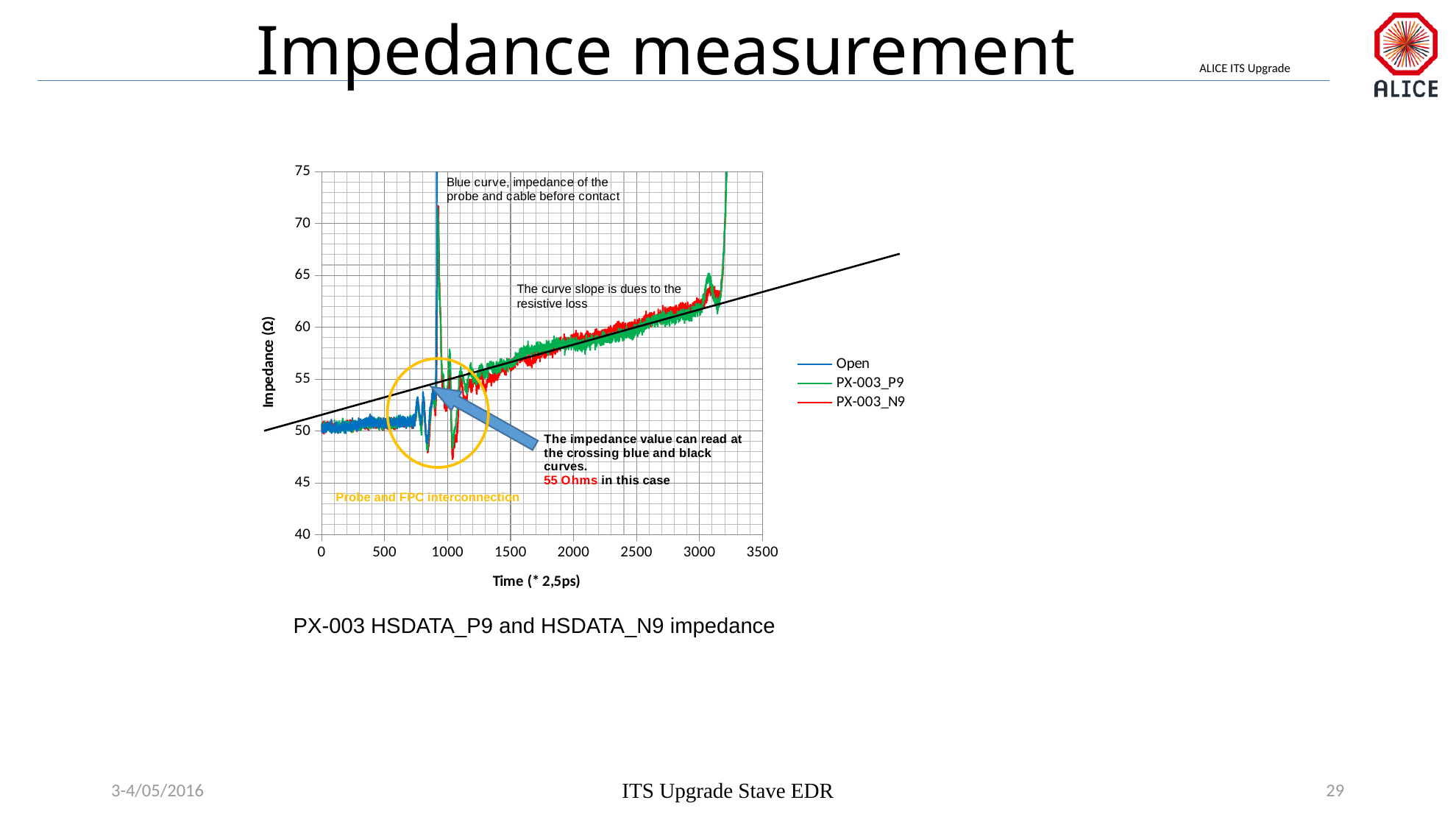
Is the value of the Open curve at time 500 greater or less than 55? less How many series does the legend list? 3 What is the highest tick value shown on the x axis? 3500 Is the value of the PX-003_N9 curve at time 2500 greater or less than 55? greater According to the annotation, what impedance value is read at the crossing of the blue and black curves? 55 Ohms Is the value of the PX-003_P9 curve at time 2000 greater or less than 65? less Between time 1500 and time 3000, do the PX-003_P9 values rise or fall? rise What is the highest tick value shown on the y axis? 75 What kind of chart is shown on the slide? line chart What is the label of the y axis? Impedance (Ω) Which series is drawn in blue according to the legend? Open